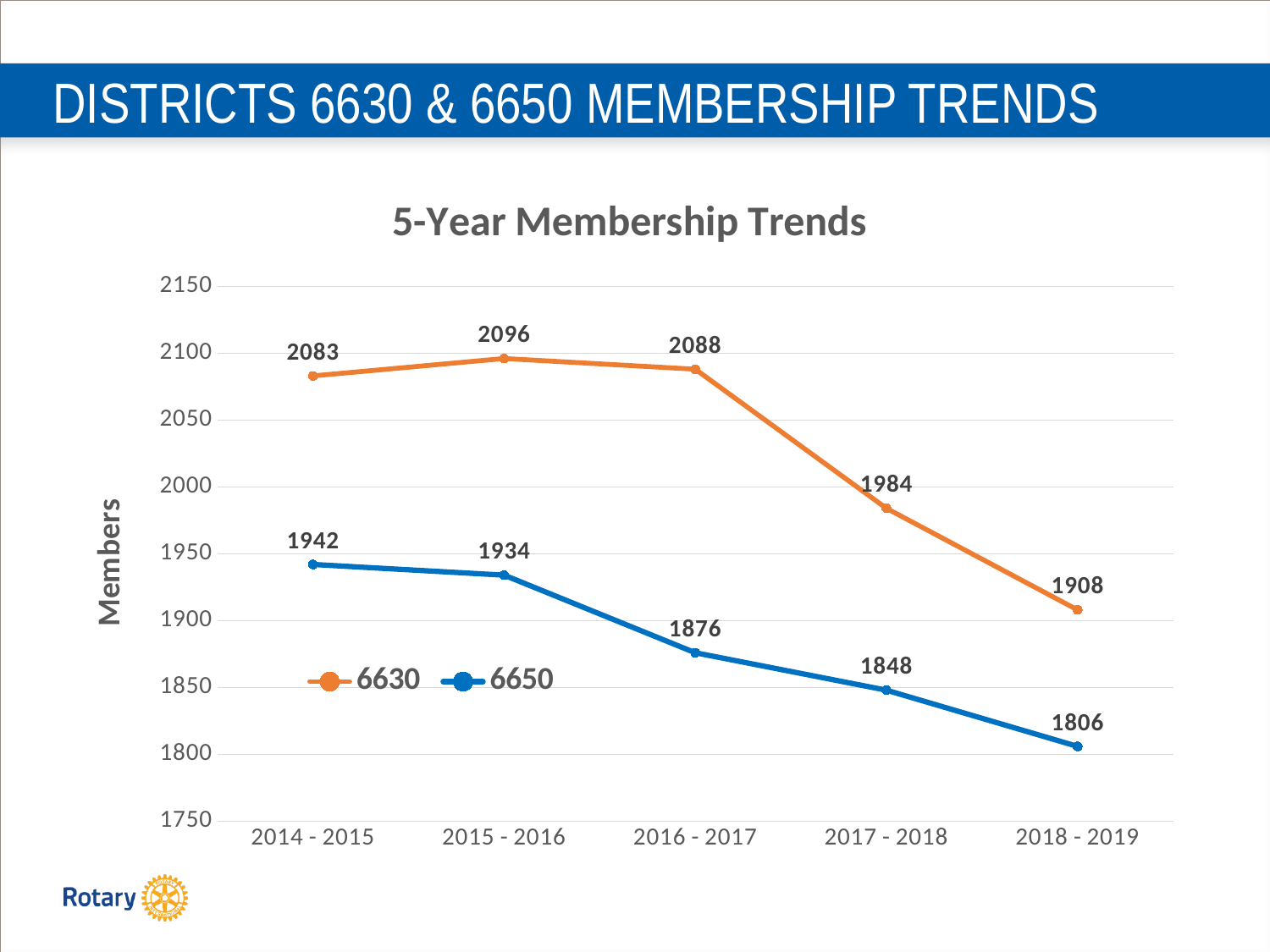
What is the title of the chart? 5-Year Membership Trends What kind of chart is shown on the slide? Line chart What is the difference between district 6630 and district 6650 membership in 2014 - 2015? 141 How many series does the legend list? 2 What is the membership value for district 6650 in 2018 - 2019? 1806 What is the membership value for district 6630 in 2015 - 2016? 2096 In which year is district 6650's membership lowest? 2018 - 2019 How much did district 6630's membership fall from 2016 - 2017 to 2018 - 2019? 180 Which district had more members in 2017 - 2018? 6630 How many years are shown on the x axis? 5 In which year is district 6630's membership highest? 2015 - 2016 What is the membership value for district 6650 in 2016 - 2017? 1876